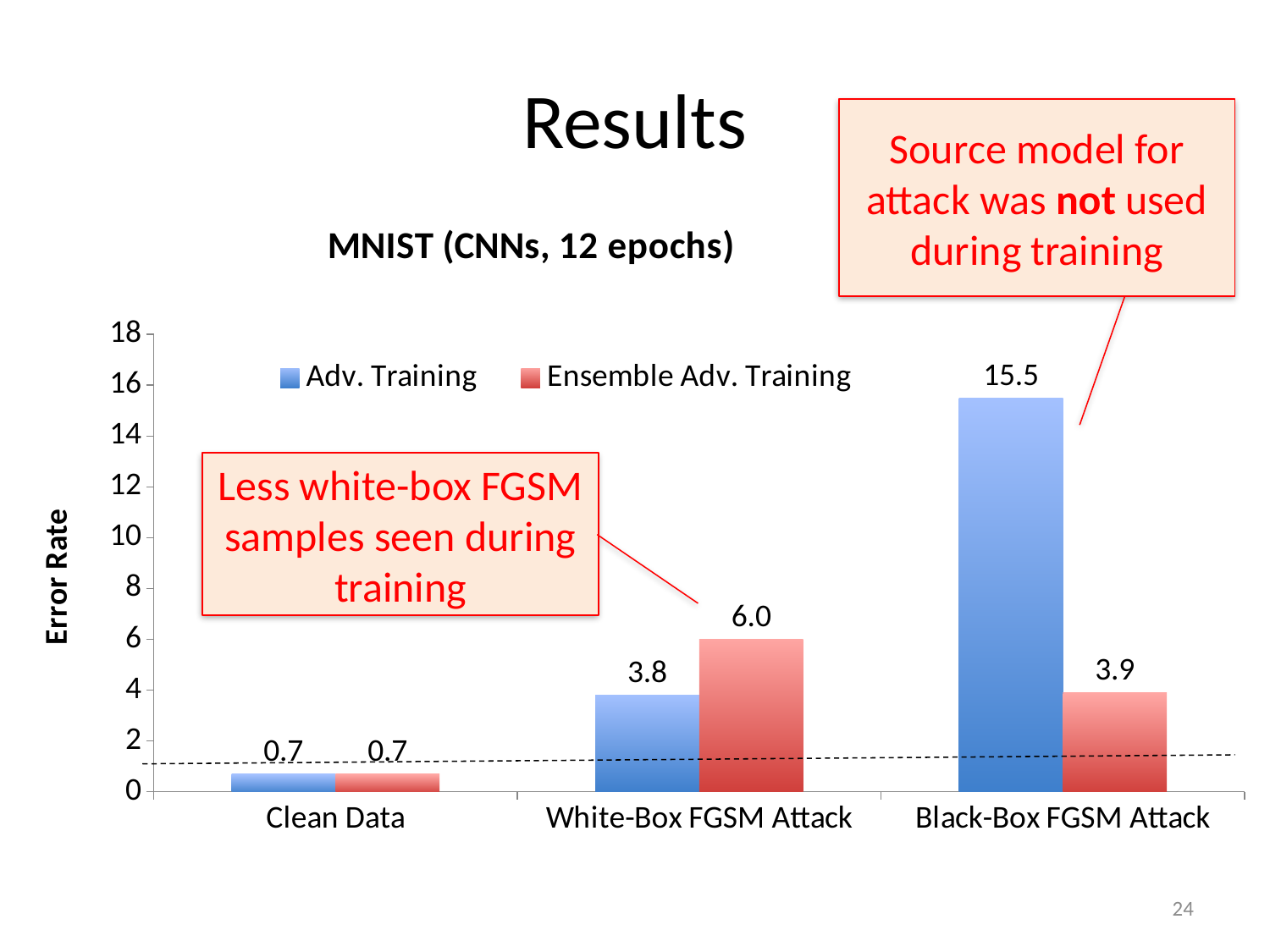
What kind of chart is shown on the slide? Bar chart Which category has the highest error rate for Adv. Training? Black-Box FGSM Attack Under the White-Box FGSM Attack, which series has the higher error rate? Ensemble Adv. Training What is the error rate for Adv. Training on Clean Data? 0.7 How many categories are shown on the x axis? 3 Which category has the lowest error rate for Ensemble Adv. Training? Clean Data What is the difference between the Adv. Training and Ensemble Adv. Training error rates under the Black-Box FGSM Attack? 11.6 What is the error rate for Ensemble Adv. Training under the Black-Box FGSM Attack? 3.9 What is the error rate for Ensemble Adv. Training under the White-Box FGSM Attack? 6.0 What is the title of the chart? MNIST (CNNs, 12 epochs) What is the error rate for Adv. Training under the Black-Box FGSM Attack? 15.5 How many series does the legend list? 2